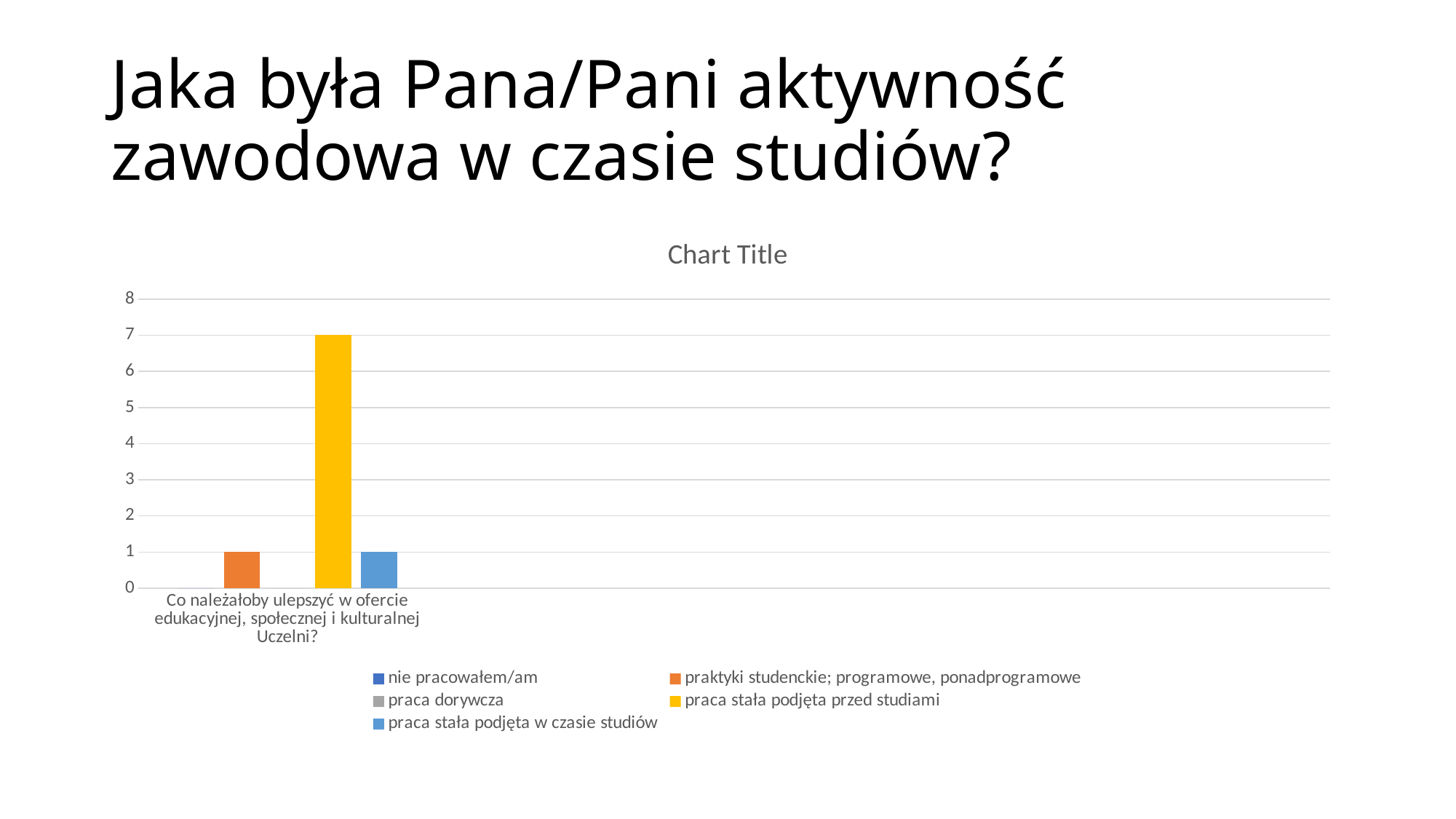
How many categories are shown on the x axis? 1 Which is larger: the value for "praca stała podjęta przed studiami" or the value for "praktyki studenckie; programowe, ponadprogramowe"? praca stała podjęta przed studiami How many series does the chart legend list? 5 What is the title shown above the chart? Chart Title What is the difference between the values for "praca stała podjęta przed studiami" and "praca stała podjęta w czasie studiów"? 6 What kind of chart is shown on the slide? bar chart Is the value for "praca stała podjęta przed studiami" greater or less than 5? greater What is the value for "praca stała podjęta przed studiami"? 7 What is the value for "praca stała podjęta w czasie studiów"? 1 What colour is the bar for "praca stała podjęta przed studiami"? yellow Which series has the highest value? praca stała podjęta przed studiami What is the value for "praktyki studenckie; programowe, ponadprogramowe"? 1